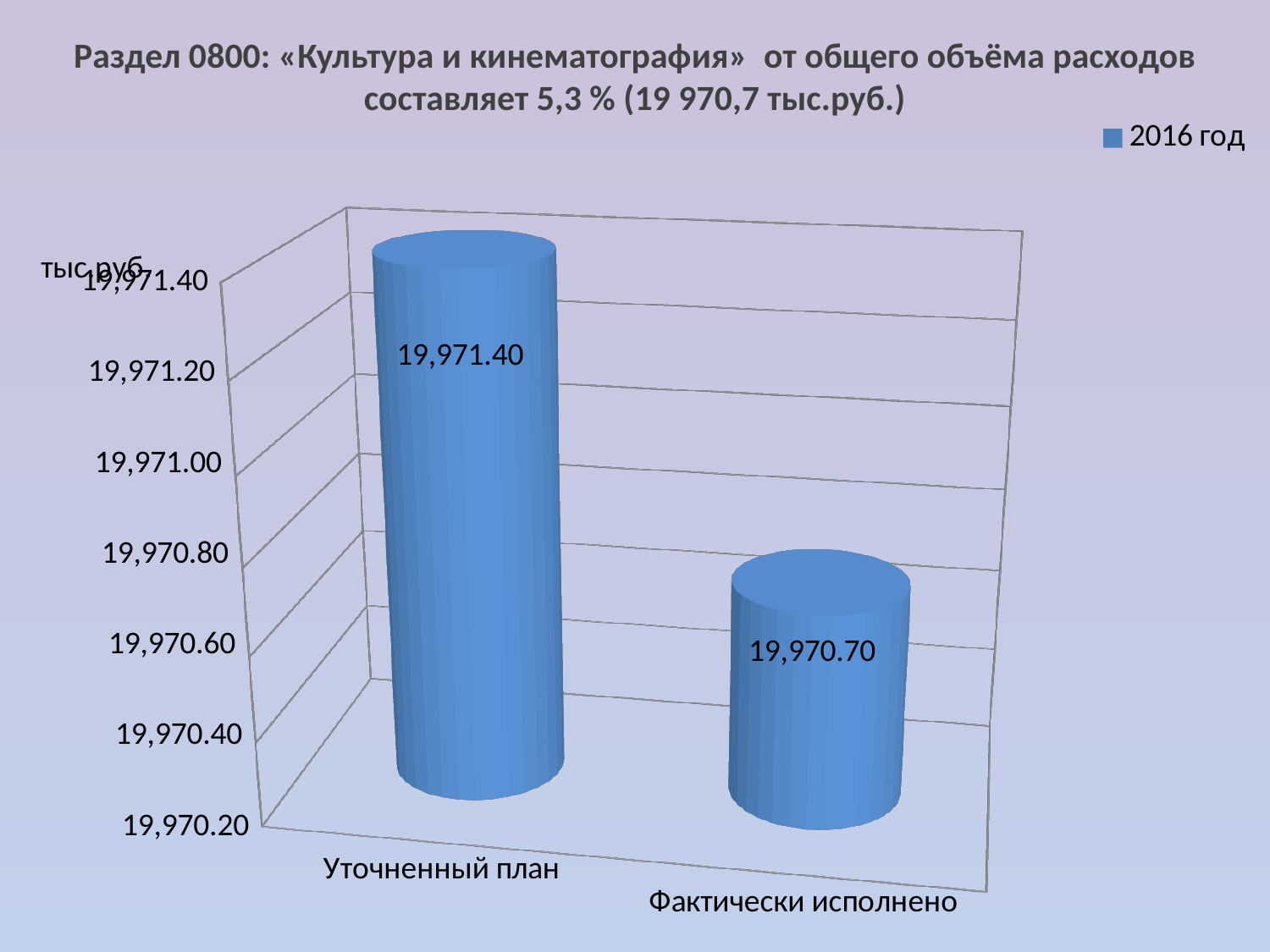
Which is larger: the value for «Уточненный план» or for «Фактически исполнено»? Уточненный план What series name is shown in the chart legend? 2016 год What is the difference between the values for «Уточненный план» and «Фактически исполнено»? 0.70 Is the value for «Фактически исполнено» greater or less than 19,971.00? less What is the value for «Фактически исполнено»? 19,970.70 How many categories are shown on the chart? 2 What kind of chart is shown on the slide? bar chart How many series does the legend list? 1 Which category has the lowest value? Фактически исполнено Which category has the highest value? Уточненный план Is the value for «Уточненный план» greater or less than 19,971.00? greater What is the value for «Уточненный план»? 19,971.40